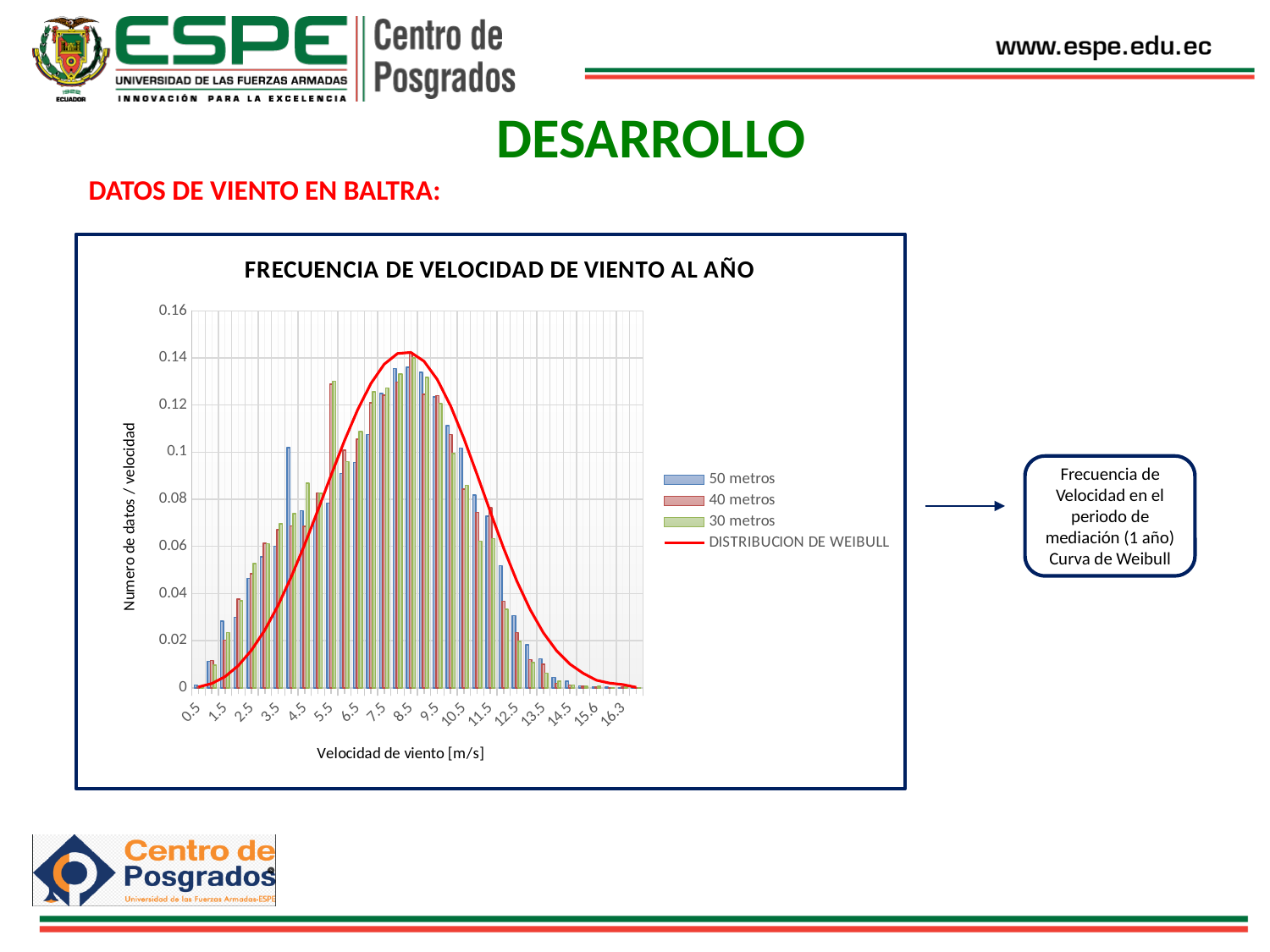
Do the values of the DISTRIBUCION DE WEIBULL curve rise or fall from 8.5 m/s to 16.3 m/s? fall How many series does the legend list? 4 Is the value for 40 metros at 12.5 m/s greater or less than 0.08? less Is the peak of the DISTRIBUCION DE WEIBULL curve greater or less than 0.12? greater Is the value for 30 metros at 14.5 m/s greater or less than 0.02? less Do the values of the DISTRIBUCION DE WEIBULL curve rise or fall from 0.5 m/s to 8.5 m/s? rise What is the label of the x axis? Velocidad de viento [m/s] What type of chart is shown on the slide? combination bar and line chart What is the title of the chart? FRECUENCIA DE VELOCIDAD DE VIENTO AL AÑO